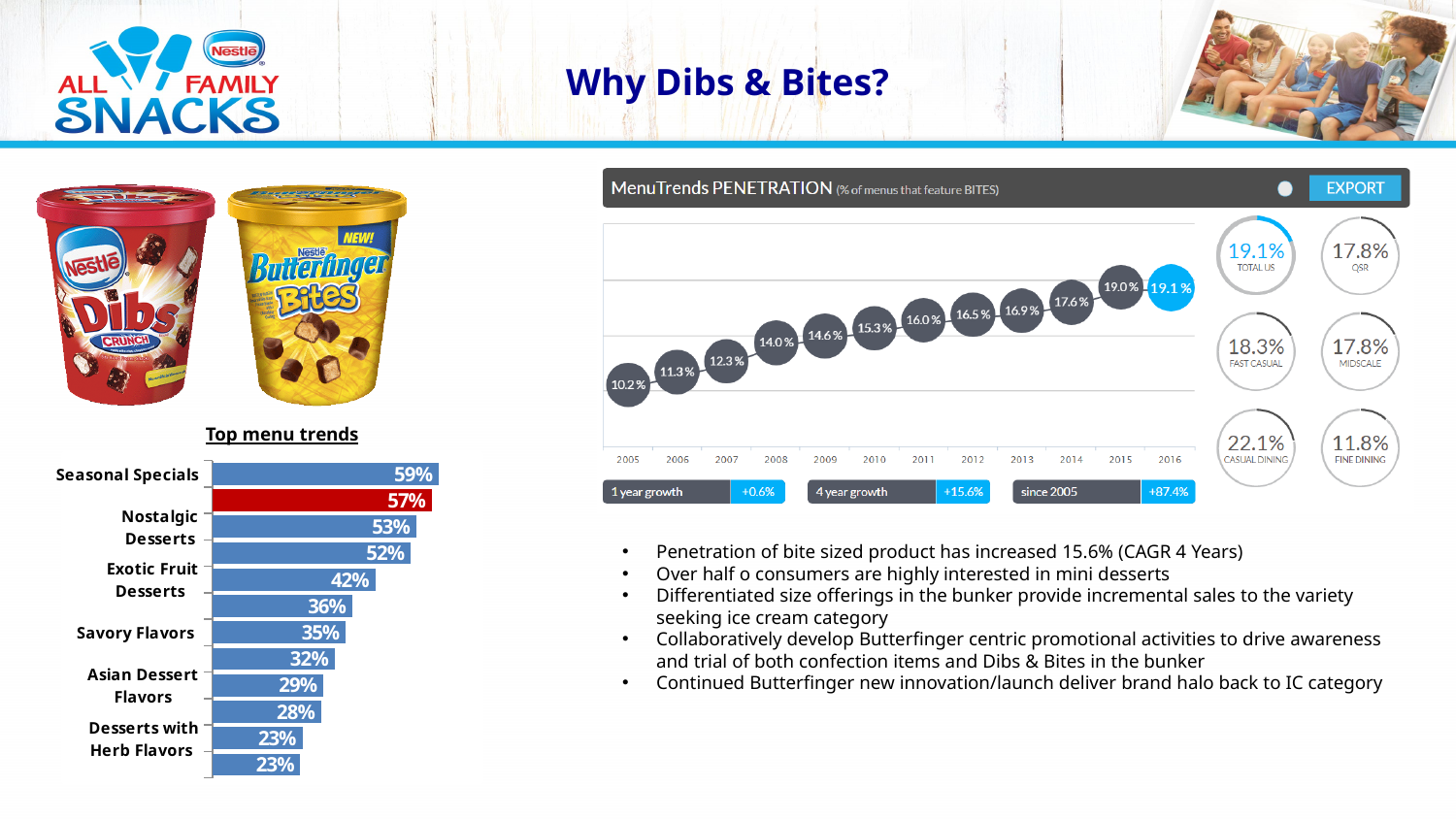
In the 'MenuTrends PENETRATION' chart, what is the value for 2005? 10.2% In the 'Top menu trends' chart, what is the value for Nostalgic Desserts? 53% In the 'Top menu trends' chart, which labeled category has the highest value? Seasonal Specials In the 'MenuTrends PENETRATION' chart, what is the difference between the 2015 and 2014 values? 1.4% In the 'Top menu trends' chart, what is the value for Seasonal Specials? 59% In the 'MenuTrends PENETRATION' chart, what is the value for 2016? 19.1% What kind of chart is the 'Top menu trends' chart? Bar chart In the 'Top menu trends' chart, what is the value for Savory Flavors? 35% In the 'MenuTrends PENETRATION' chart, what is the 4 year growth shown? +15.6% In the 'MenuTrends PENETRATION' chart, do the values rise or fall from 2005 to 2016? Rise In the 'Top menu trends' chart, what is the difference between Exotic Fruit Desserts and Asian Dessert Flavors? 13% In the 'Top menu trends' chart, how many bars are plotted? 12